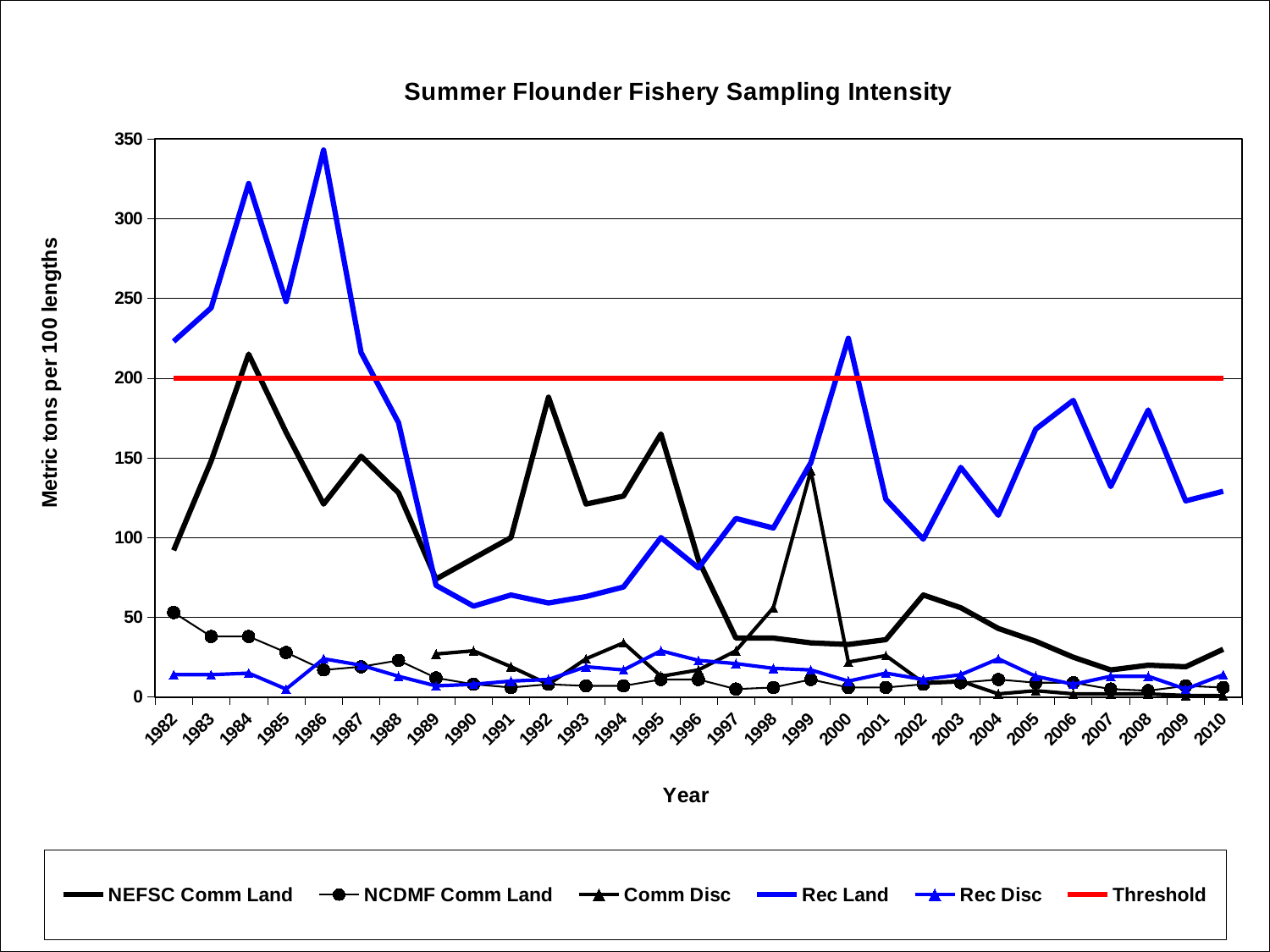
What kind of chart is shown on the slide? line chart In which year does NEFSC Comm Land reach its highest value? 1984 In which year does Rec Land reach its highest value? 1986 What is the title of the chart? Summer Flounder Fishery Sampling Intensity How many years are plotted along the x axis? 29 Is the value for NEFSC Comm Land in 1989 greater or less than 100? less How many series does the legend list? 6 Is the value for Rec Land in 1986 greater or less than 300? greater Does NEFSC Comm Land overall rise or fall from 1982 to 2010? fall What value does the Threshold line sit at? 200 Is the value for Rec Land in 2000 greater or less than 200? greater In 1999, which is larger: Comm Disc or NEFSC Comm Land? Comm Disc